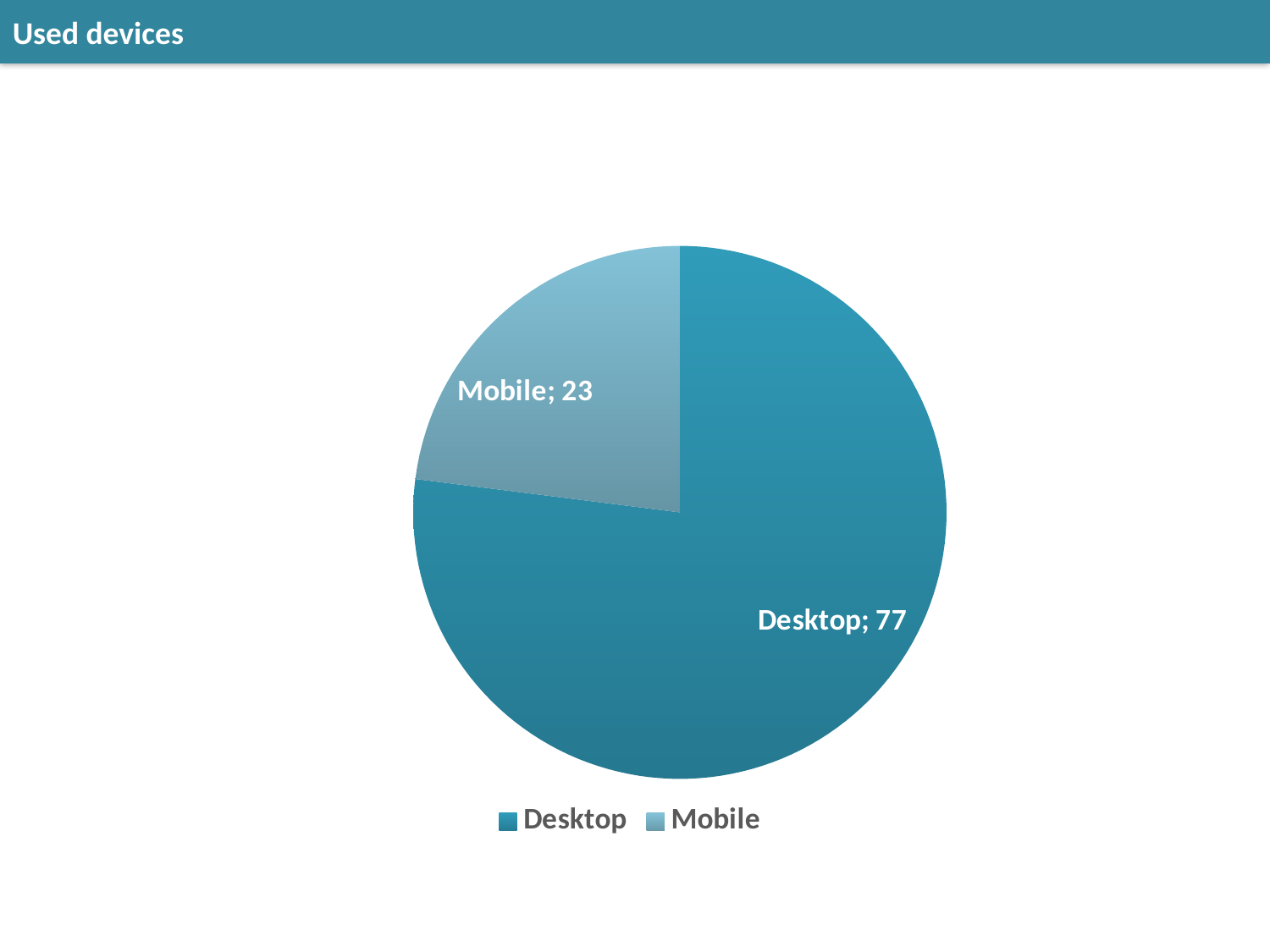
What share of the pie does Mobile represent? 23% Which category has the largest slice? Desktop What share of the pie does Desktop represent? 77% How many categories does the pie chart show? 2 What is the value for Desktop? 77 What kind of chart is shown on the slide? Pie chart What is the total of the two slices? 100 What is the value for Mobile? 23 What is the title of the slide? Used devices What is the difference between the Desktop and Mobile values? 54 Which category has the smallest slice? Mobile Which is larger, Desktop or Mobile? Desktop